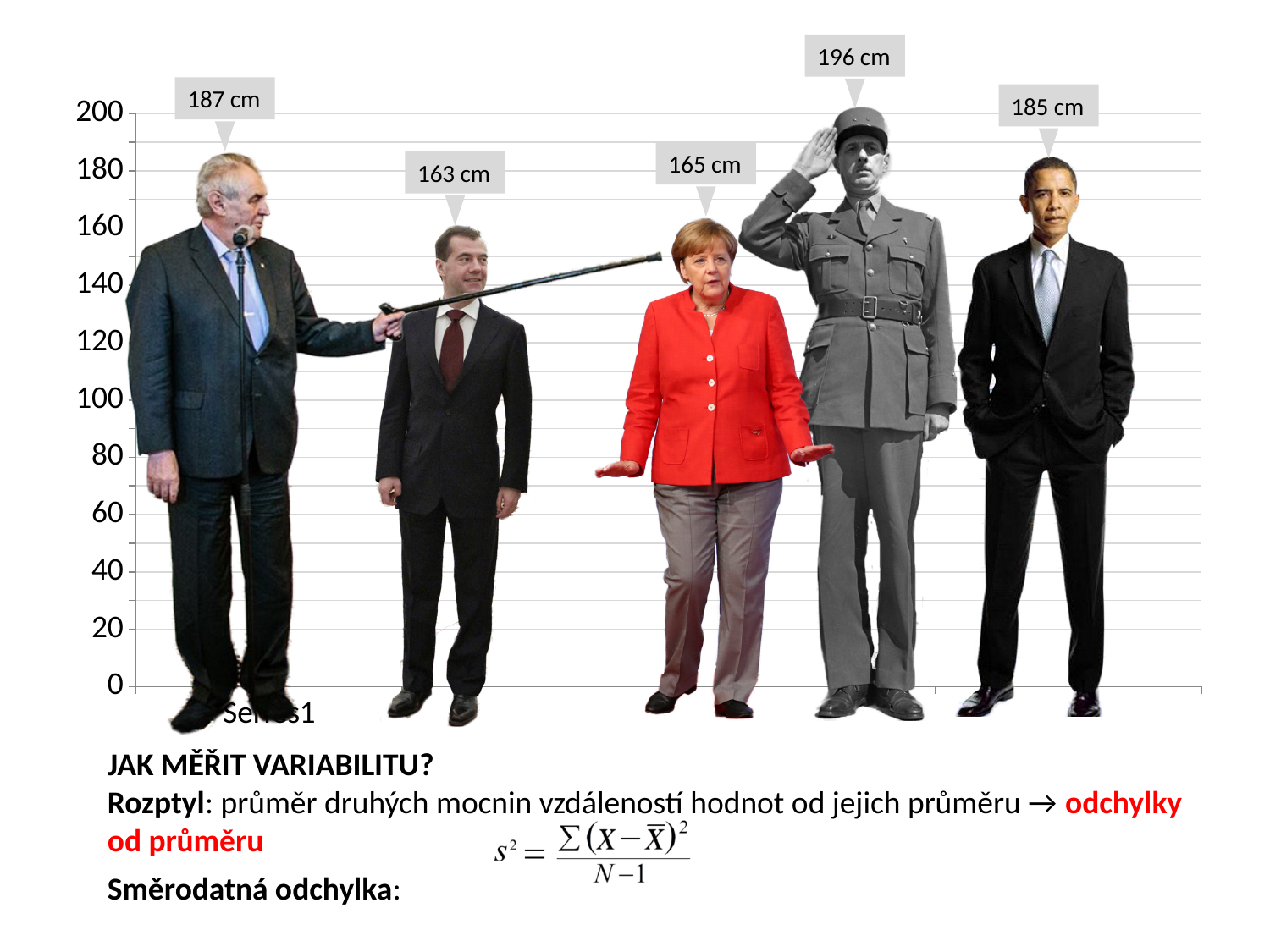
How many figures (data points) are shown in the chart? 5 What is the data label on the second figure from the left in the chart? 163 cm What is the data label on the fourth figure from the left (the saluting figure) in the chart? 196 cm What is the name of the series shown in the chart legend? Series1 What is the data label on the first (leftmost) figure in the chart? 187 cm What is the difference between the highest and lowest values shown in the chart? 33 cm Which figure has the lowest value in the chart? The second from the left (163 cm) What is the data label on the rightmost figure in the chart? 185 cm Which figure has the highest value in the chart? The fourth from the left (196 cm) Which is larger: the value for the leftmost figure or the value for the rightmost figure? The leftmost figure (187 cm) What is the data label on the third figure from the left (the one in red) in the chart? 165 cm Is the value for the third figure from the left greater or less than 180? less